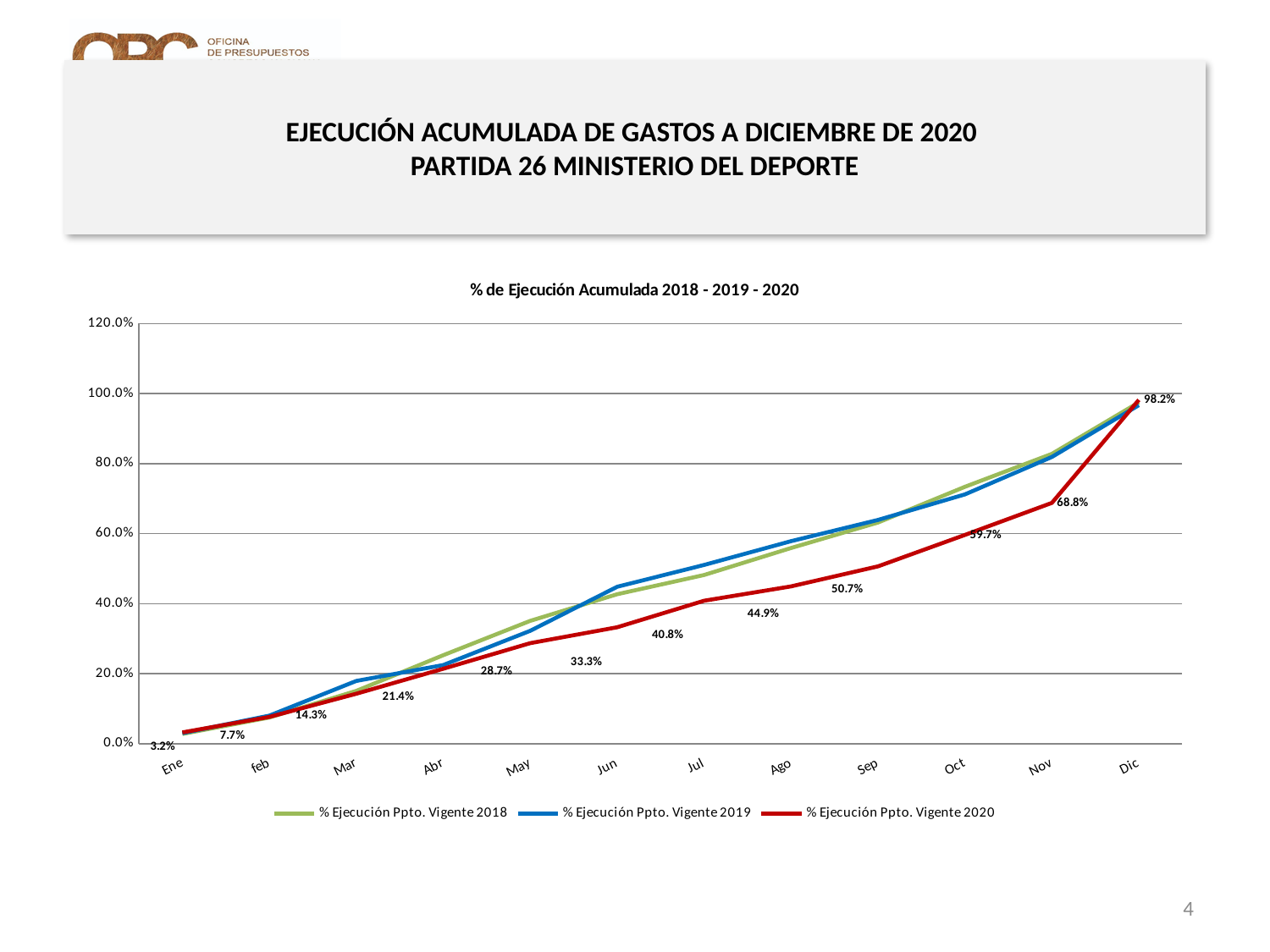
What type of chart is shown on the slide? line chart What is the value for % Ejecución Ppto. Vigente 2020 in Dic? 98.2% What is the difference between the % Ejecución Ppto. Vigente 2020 values for Nov and Sep? 18.1% Do the values for % Ejecución Ppto. Vigente 2020 rise or fall from Ene to Dic? rise How many months are shown on the x axis? 12 What is the value for % Ejecución Ppto. Vigente 2020 in Abr? 21.4% What is the title of the chart? % de Ejecución Acumulada 2018 - 2019 - 2020 How many series does the legend list? 3 Is the value for % Ejecución Ppto. Vigente 2019 in Oct greater or less than 60.0%? greater In Ago, which is larger: the value for % Ejecución Ppto. Vigente 2019 or % Ejecución Ppto. Vigente 2020? % Ejecución Ppto. Vigente 2019 In which month is the % Ejecución Ppto. Vigente 2020 value lowest? Ene What is the value for % Ejecución Ppto. Vigente 2020 in Jul? 40.8%